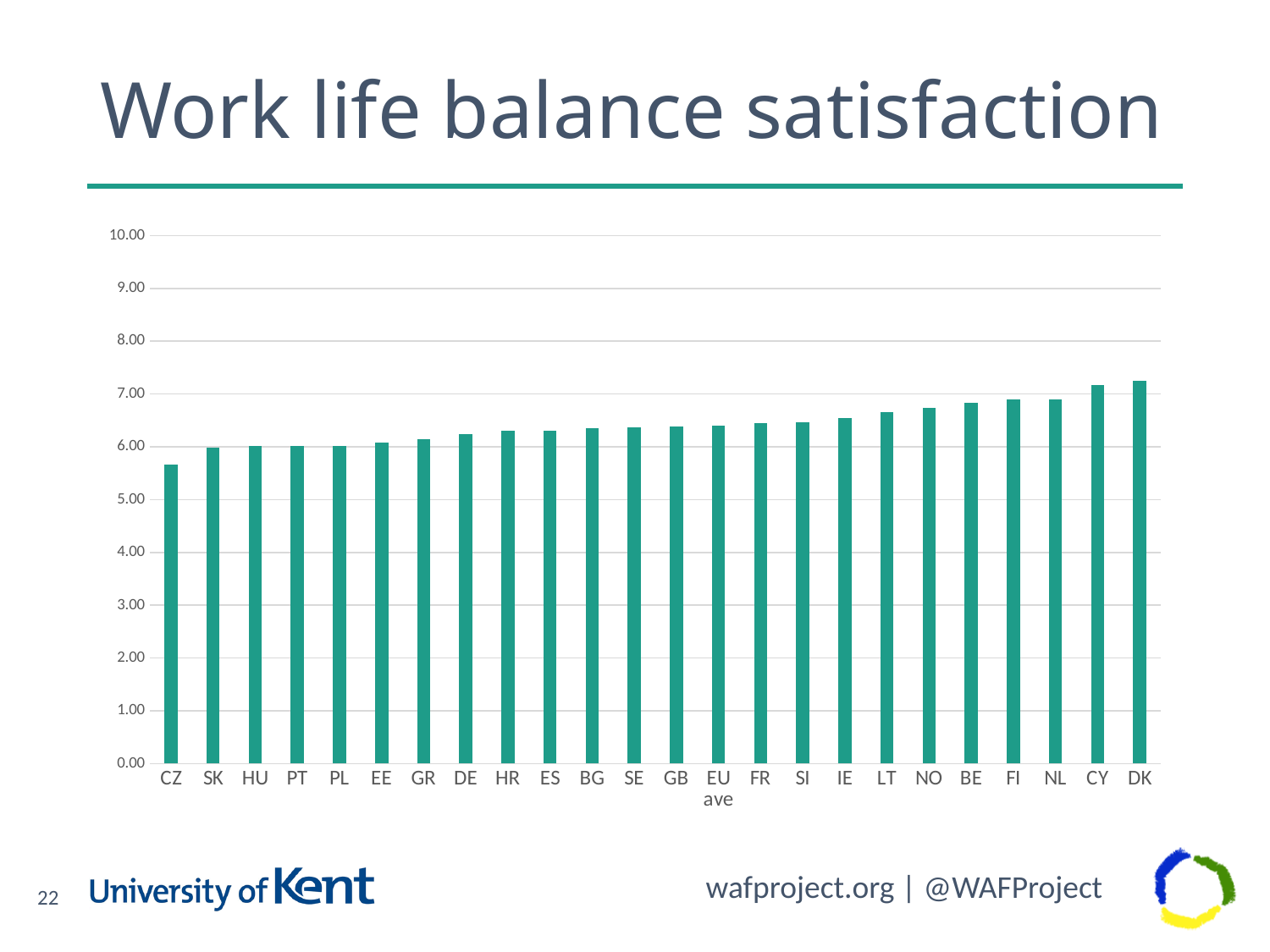
Do the values rise or fall moving from left to right along the x axis? rise Is the value for NO greater or less than 7.00? less Which category has the lowest work life balance satisfaction? CZ Is the value for CZ greater or less than 6.00? less Is the value for GR greater or less than 6.00? greater What is the title of the slide containing the chart? Work life balance satisfaction Which is larger, the value for CY or the value for LT? CY How many countries/categories are shown on the x axis? 24 Which category has the highest work life balance satisfaction? DK Which is larger, the value for GR or the value for NO? NO What kind of chart is shown on the slide? bar chart